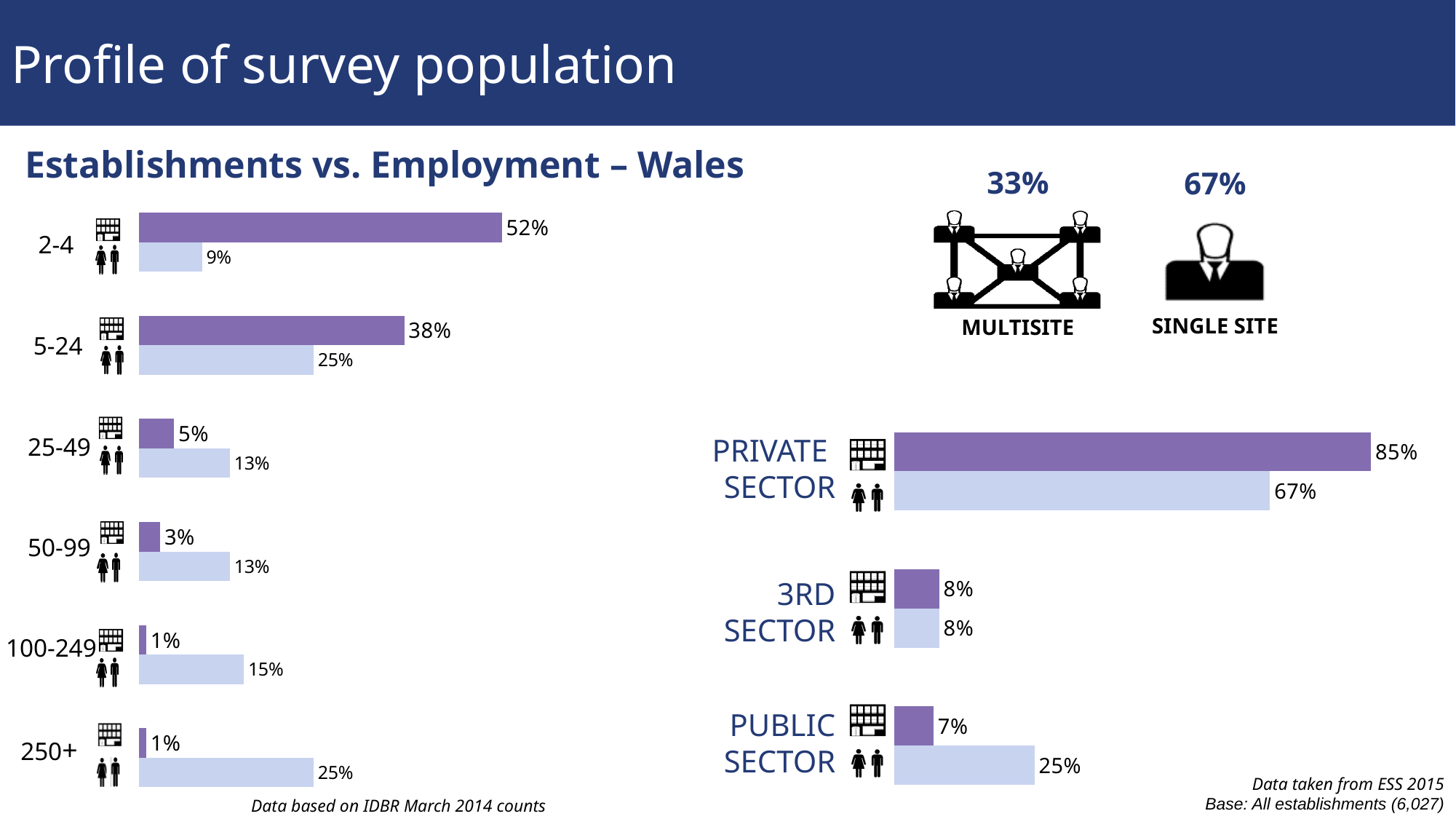
In the left chart (Establishments vs. Employment – Wales), what is the value of the dark purple bar for the 2-4 size band? 52% In the right chart by sector, which sector has the lowest dark purple bar? Public Sector In the left chart (Establishments vs. Employment – Wales), do the dark purple bar values rise or fall as the size bands increase from 2-4 to 250+? fall In the left chart (Establishments vs. Employment – Wales), what is the value of the light purple bar for the 250+ size band? 25% In the right chart by sector, what is the value of the dark purple bar for the Private Sector? 85% What percentage of establishments are shown as Multisite in the infographic at the top right? 33% In the right chart by sector, what is the difference between the dark purple and light purple bars for the Private Sector? 18% In the right chart by sector, what is the value of the light purple bar for the Public Sector? 25% What kind of chart is used for the Establishments vs. Employment – Wales data? bar chart In the left chart (Establishments vs. Employment – Wales), how many size bands are shown? 6 In the left chart (Establishments vs. Employment – Wales), what is the difference between the dark purple and light purple bars for the 5-24 size band? 13% In the left chart (Establishments vs. Employment – Wales), which size band has the highest dark purple bar? 2-4